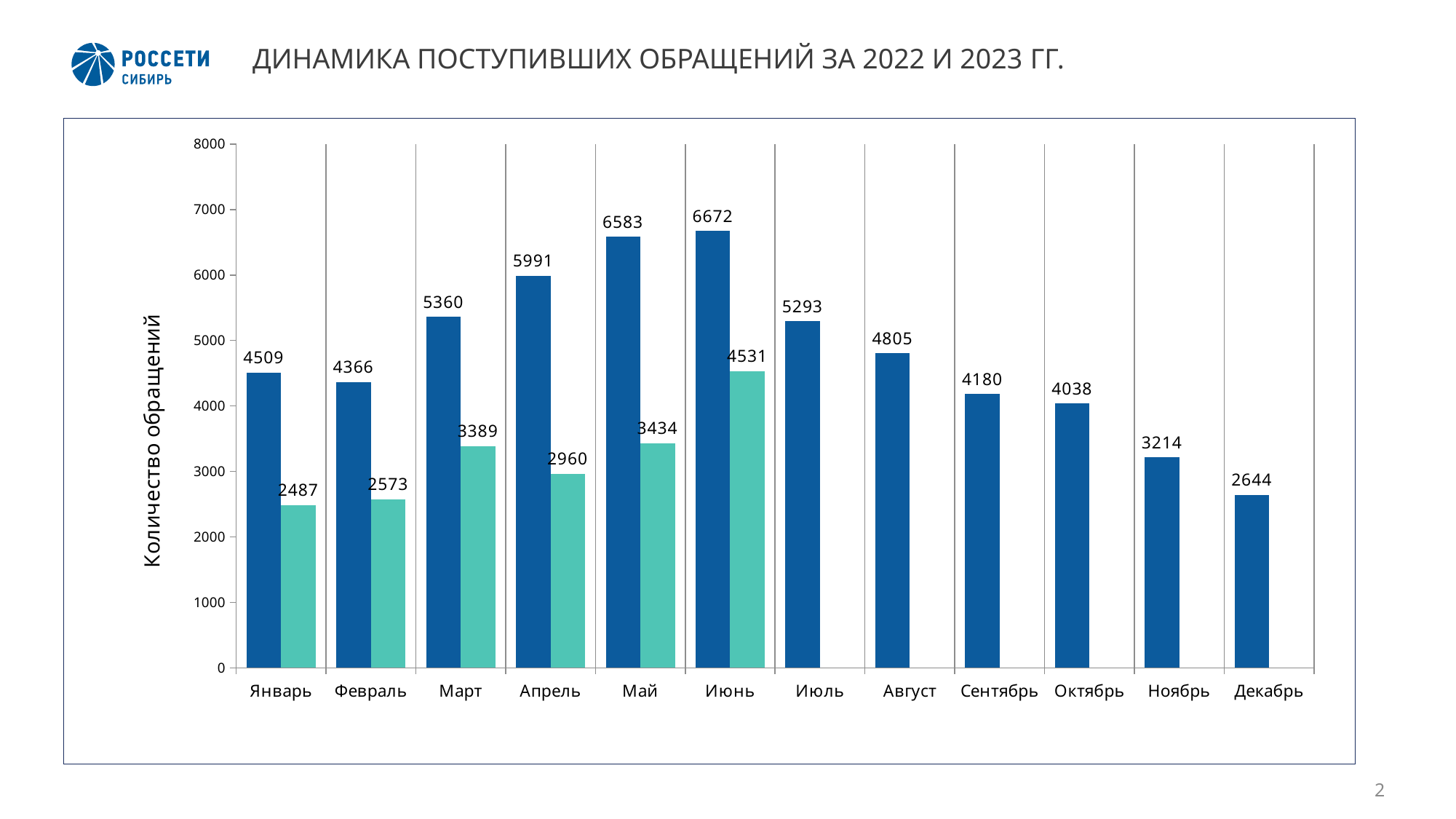
How many months are shown on the x axis? 12 Which month has the highest dark blue bar? Июнь How many months have a teal bar? 6 Which month has the lowest teal bar? Январь Which is larger: the dark blue bar for Апрель or the dark blue bar for Август? Апрель What is the value of the teal bar for Март? 3389 What is the value of the dark blue bar for Май? 6583 Is the teal bar for Июнь greater or less than 4000? greater Do the dark blue bars rise or fall from Июнь to Декабрь? fall What is the difference between the dark blue and teal bars for Июнь? 2141 What kind of chart is shown on the slide? bar chart What is the value of the dark blue bar for Декабрь? 2644